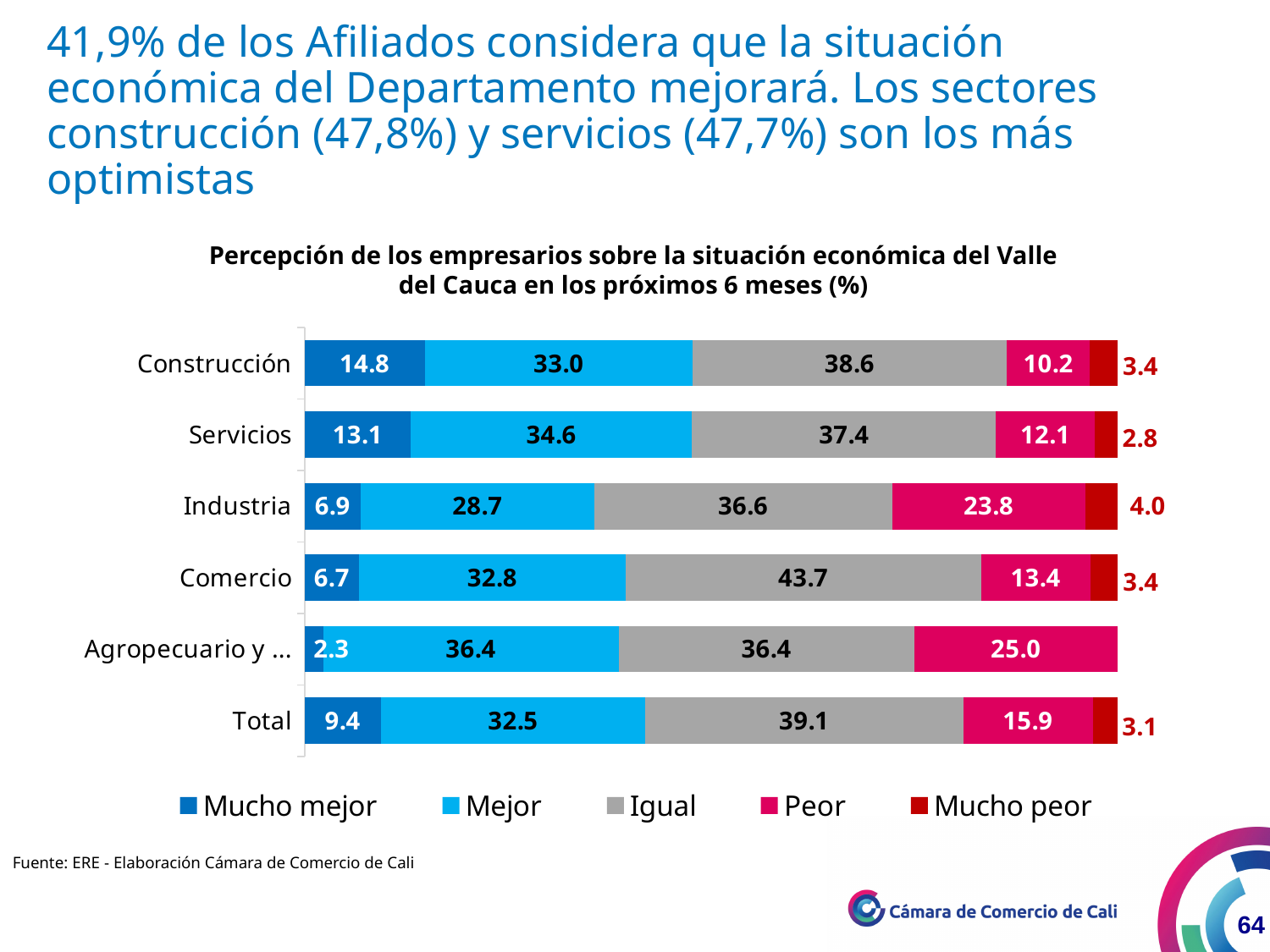
Which category has the highest value for "Igual"? Comercio How many categories are shown on the chart? 6 What is the value of "Mejor" for Construcción? 33.0 Which category has the lowest value for "Mucho mejor"? Agropecuario y ... Which category has the highest value for "Mucho mejor"? Construcción Which is larger: the "Mejor" value for Servicios or for Construcción? Servicios What kind of chart is shown on the slide? Stacked bar chart What is the value of "Mucho peor" for Servicios? 2.8 What is the value of "Igual" for Total? 39.1 What is the value of "Peor" for Industria? 23.8 What is the difference between the "Mejor" and "Mucho mejor" values for Construcción? 18.2 How many series does the legend list? 5